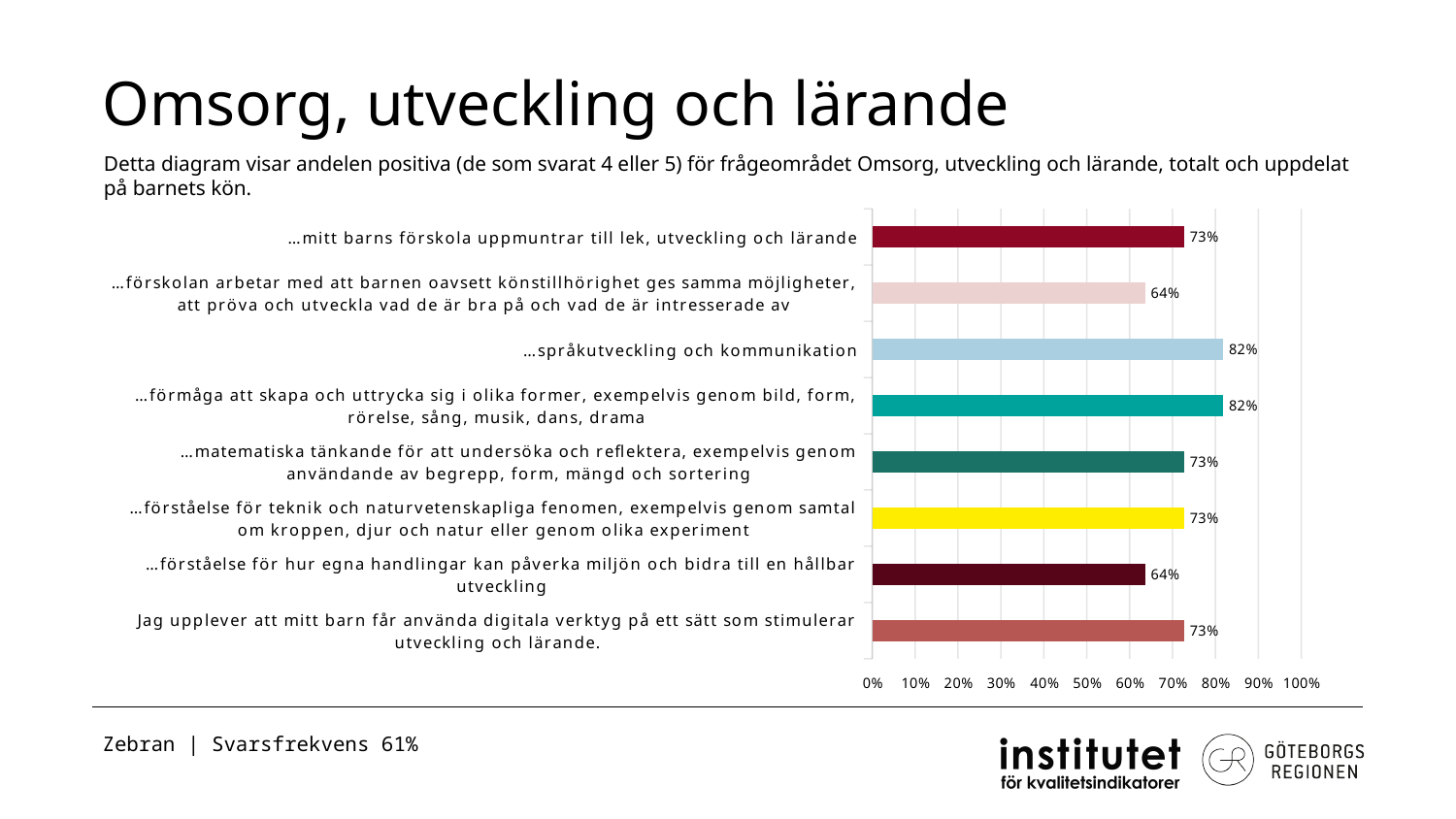
Which has the larger value: "…förmåga att skapa och uttrycka sig i olika former, exempelvis genom bild, form, rörelse, sång, musik, dans, drama" or "…förståelse för hur egna handlingar kan påverka miljön och bidra till en hållbar utveckling"? …förmåga att skapa och uttrycka sig i olika former, exempelvis genom bild, form, rörelse, sång, musik, dans, drama Is the value for "…matematiska tänkande för att undersöka och reflektera, exempelvis genom användande av begrepp, form, mängd och sortering" greater or less than 80%? less What is the value for "…förståelse för hur egna handlingar kan påverka miljön och bidra till en hållbar utveckling"? 64% What is the lowest value shown in the chart? 64% What is the highest value shown in the chart? 82% How many categories (bars) are shown in the chart? 8 What is the title of the slide containing the chart? Omsorg, utveckling och lärande What is the difference between the value for "…språkutveckling och kommunikation" and the value for "…förskolan arbetar med att barnen oavsett könstillhörighet ges samma möjligheter, att pröva och utveckla vad de är bra på och vad de är intresserade av"? 18 percentage points What is the value for "Jag upplever att mitt barn får använda digitala verktyg på ett sätt som stimulerar utveckling och lärande."? 73% What kind of chart is shown on the slide? Bar chart What is the value for "…språkutveckling och kommunikation"? 82% What is the value for "…mitt barns förskola uppmuntrar till lek, utveckling och lärande"? 73%